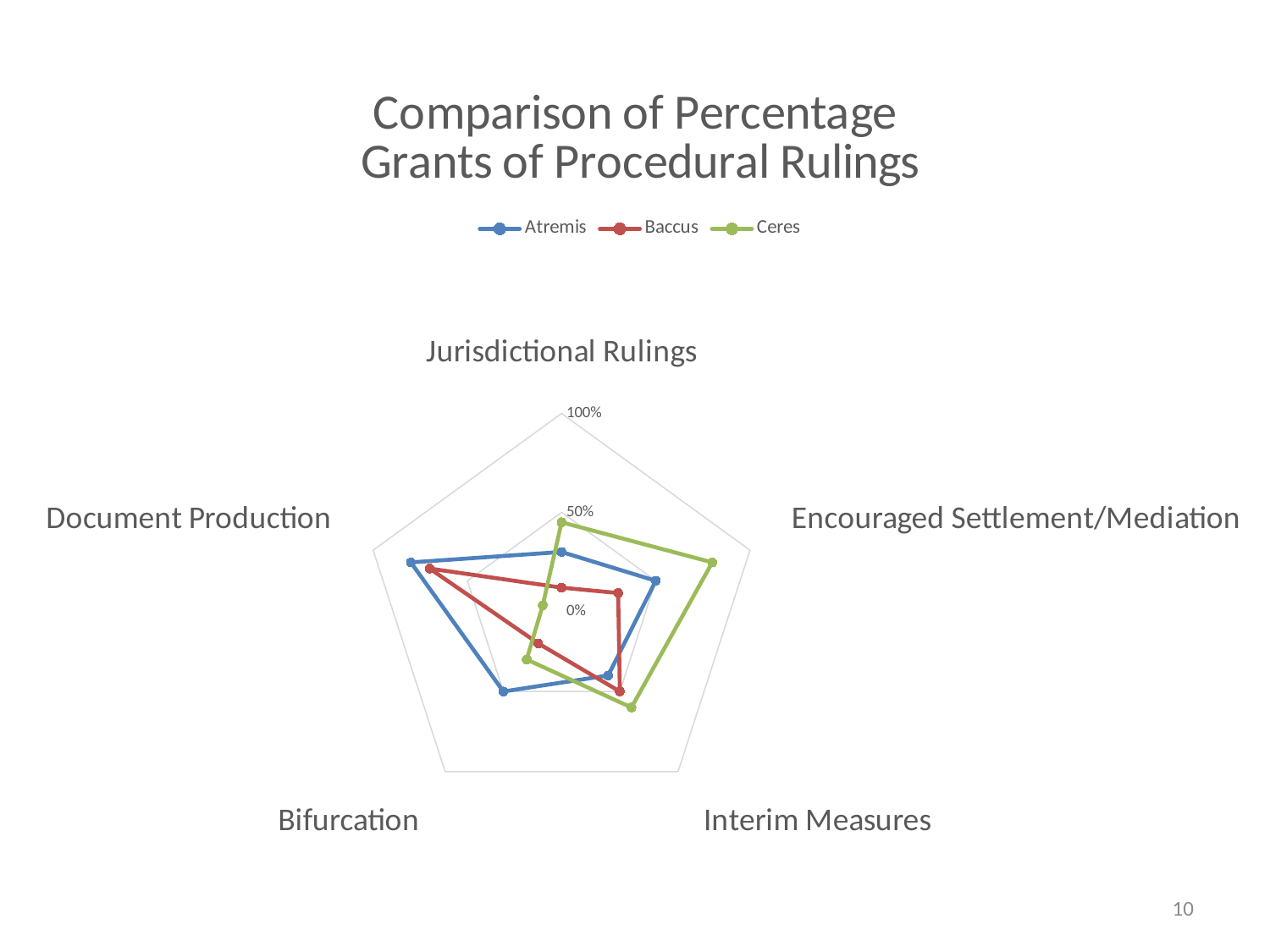
Is the value for Ceres on Encouraged Settlement/Mediation greater or less than 50%? greater Is the value for Atremis on Document Production greater or less than 50%? greater What kind of chart is shown on the slide? Radar chart How many series does the legend list? 3 How many categories (axes) does the radar chart have? 5 Which series has the highest value for Encouraged Settlement/Mediation? Ceres For Interim Measures, which series has the larger value, Ceres or Atremis? Ceres Which series has the lowest value for Document Production? Ceres Which series has the highest value for Bifurcation? Atremis Which series has the lowest value for Jurisdictional Rulings? Baccus What is the title of the chart? Comparison of Percentage Grants of Procedural Rulings Which series has the highest value for Document Production? Atremis